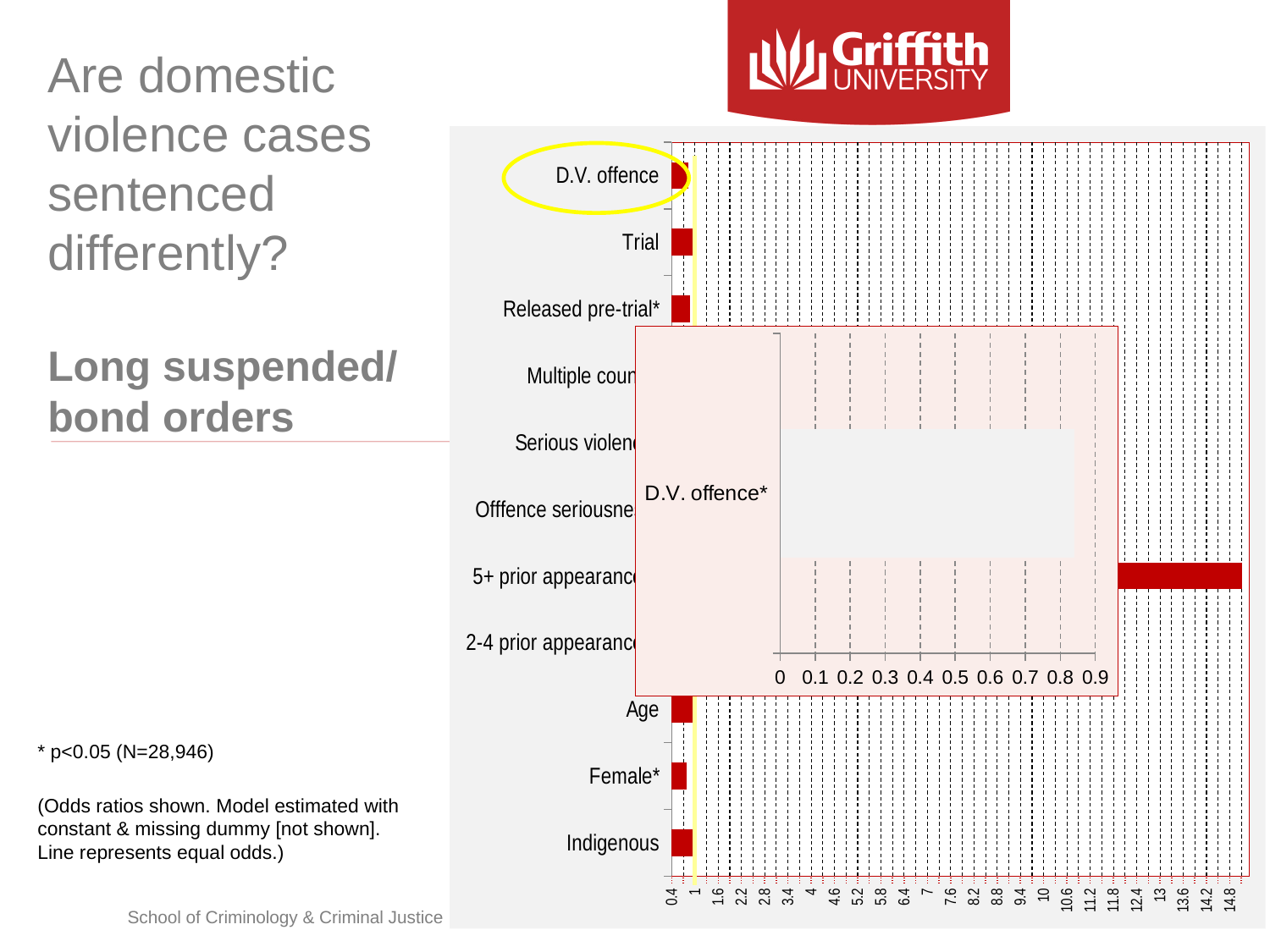
What kind of chart is the main chart on the slide? bar chart In the inset chart, how many bars are plotted? 1 In the inset chart, which category is plotted? D.V. offence* In the inset chart, is the value for D.V. offence* greater or less than 0.8? greater In the main chart, what is the highest tick label shown on the horizontal axis? 14.8 In the main chart, is the value for Indigenous greater or less than 2.2? less In the main chart, is the value for Female* greater or less than 1.6? less In the main chart, which category is larger, 5+ prior appearances or Trial? 5+ prior appearances In the main chart, which category has the highest value? 5+ prior appearances In the main chart, how many categories are listed on the vertical axis? 11